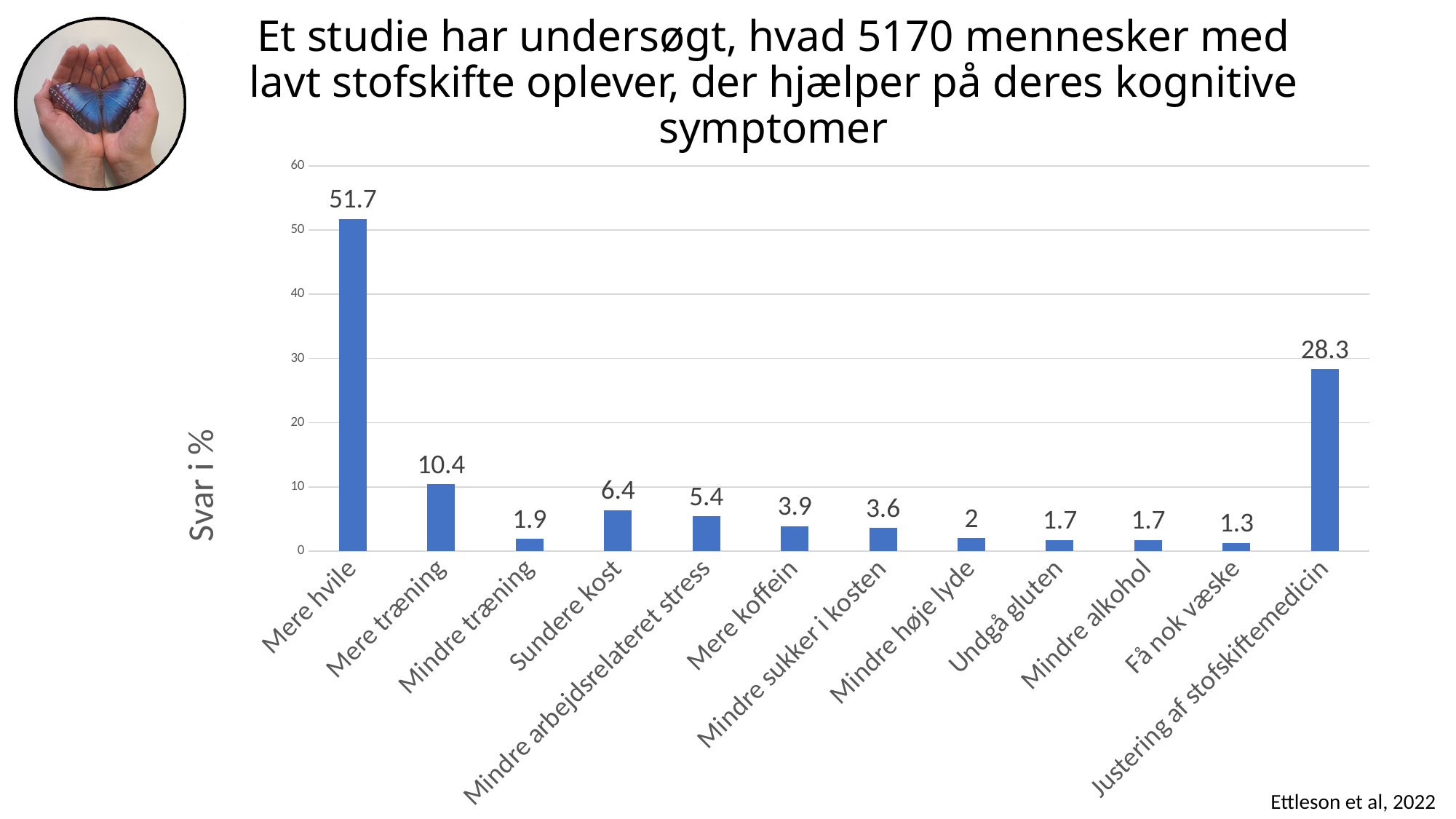
What is the value for "Mere hvile"? 51.7 What is the label of the y axis? Svar i % How many categories are shown on the x axis? 12 Which is larger, the value for "Sundere kost" or the value for "Mere koffein"? Sundere kost Which category has the lowest value? Få nok væske Is the value for "Mere træning" greater or less than 10? greater Which category has the highest value? Mere hvile What is the difference between the values for "Mere hvile" and "Justering af stofskiftemedicin"? 23.4 What is the difference between the values for "Mere træning" and "Mindre træning"? 8.5 What is the value for "Mindre arbejdsrelateret stress"? 5.4 What kind of chart is shown on the slide? bar chart What is the value for "Justering af stofskiftemedicin"? 28.3